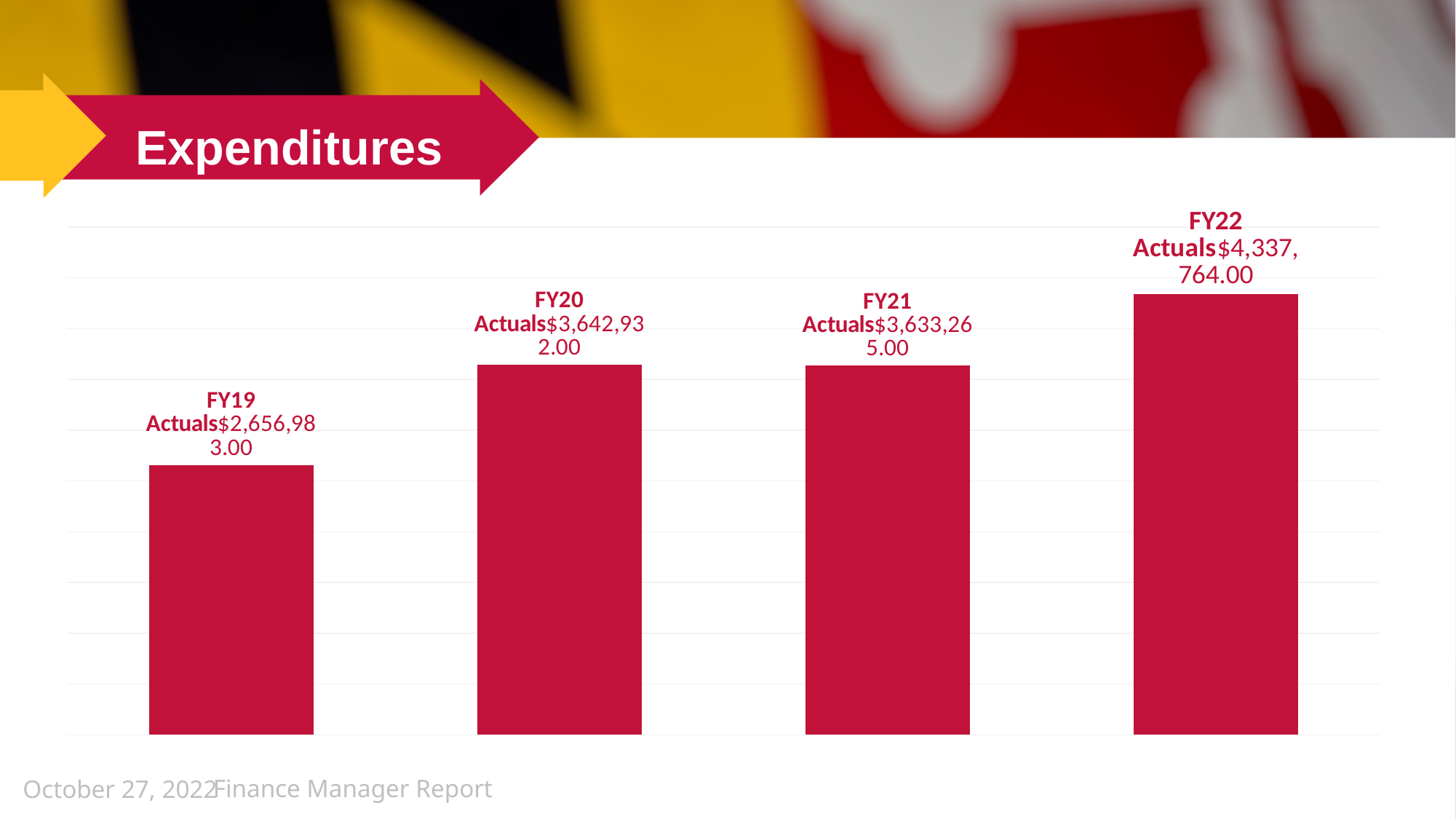
What is the value for FY20 Actuals? $3,642,932.00 What is the difference between FY20 Actuals and FY21 Actuals? $9,667.00 Which fiscal year has the lowest expenditures? FY19 Which is larger, FY20 Actuals or FY21 Actuals? FY20 Actuals What is the title of the slide containing the chart? Expenditures What is the value for FY21 Actuals? $3,633,265.00 Which fiscal year has the highest expenditures? FY22 What kind of chart is shown on the slide? Bar chart What is the value for FY22 Actuals? $4,337,764.00 How many fiscal years are shown in the chart? 4 What is the value for FY19 Actuals? $2,656,983.00 What is the difference between FY22 Actuals and FY19 Actuals? $1,680,781.00